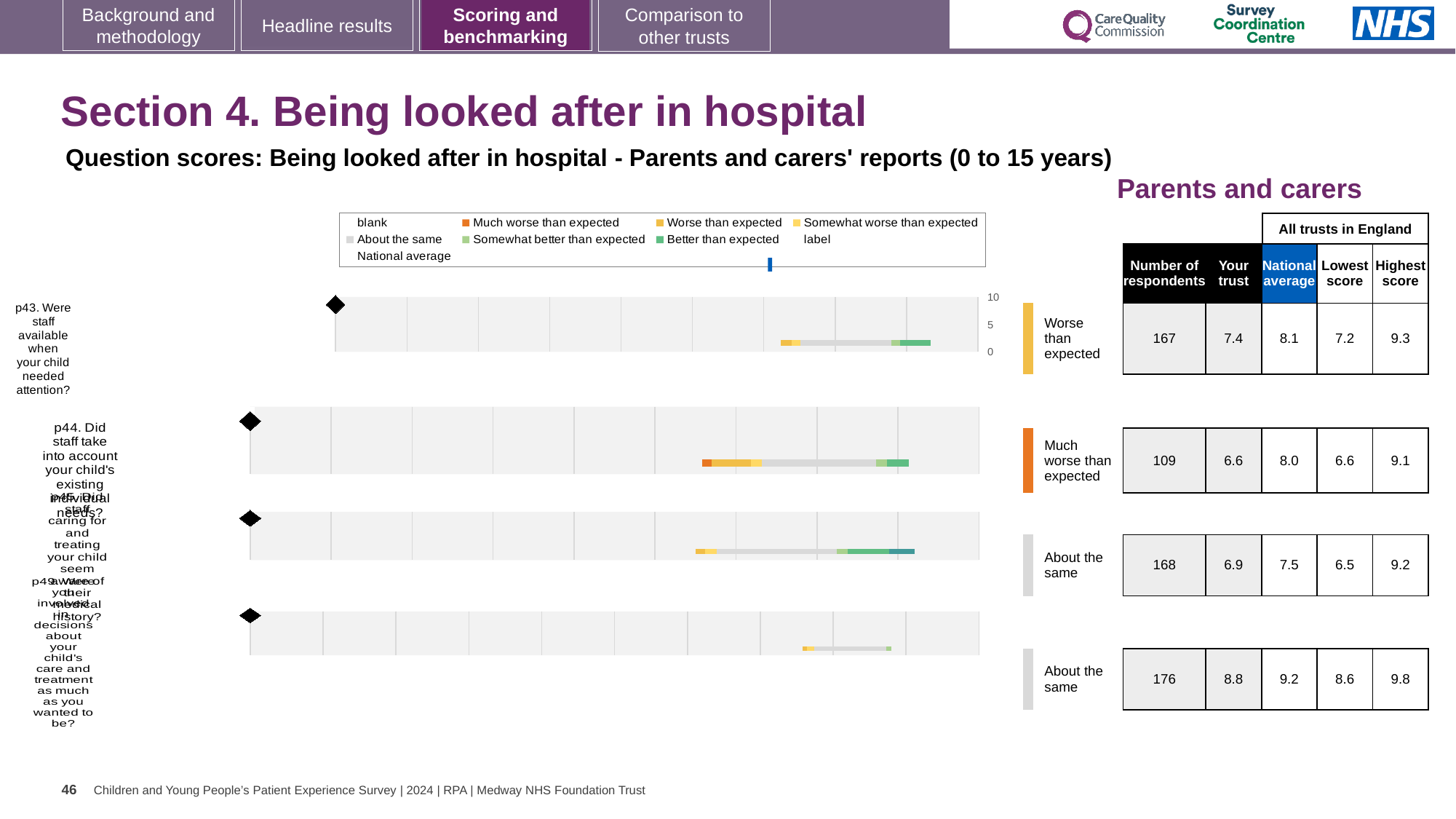
What kind of chart is used for the question scores on this slide? bar chart For the p43 chart (Were staff available when your child needed attention?), what is the 'Your trust' score shown in the table? 7.4 For the p44 chart, what is the highest score among all trusts in England? 9.1 For the p43 chart, how many respondents are listed? 167 What is the maximum value shown on the score axis of the top chart? 10 For the p44 chart, what is the difference between the national average and the 'Your trust' score? 1.4 What benchmark category is shown next to the p44 chart? Much worse than expected For the p43 chart, which is larger: the 'Your trust' score or the national average? National average For the p44 chart (Did staff take into account your child's existing individual needs?), what is the 'Your trust' score? 6.6 Which of the four charts has the highest 'Your trust' score? The bottom chart (p49), 8.8 How many question charts are shown on the slide? 4 For the p43 chart, what is the national average score? 8.1